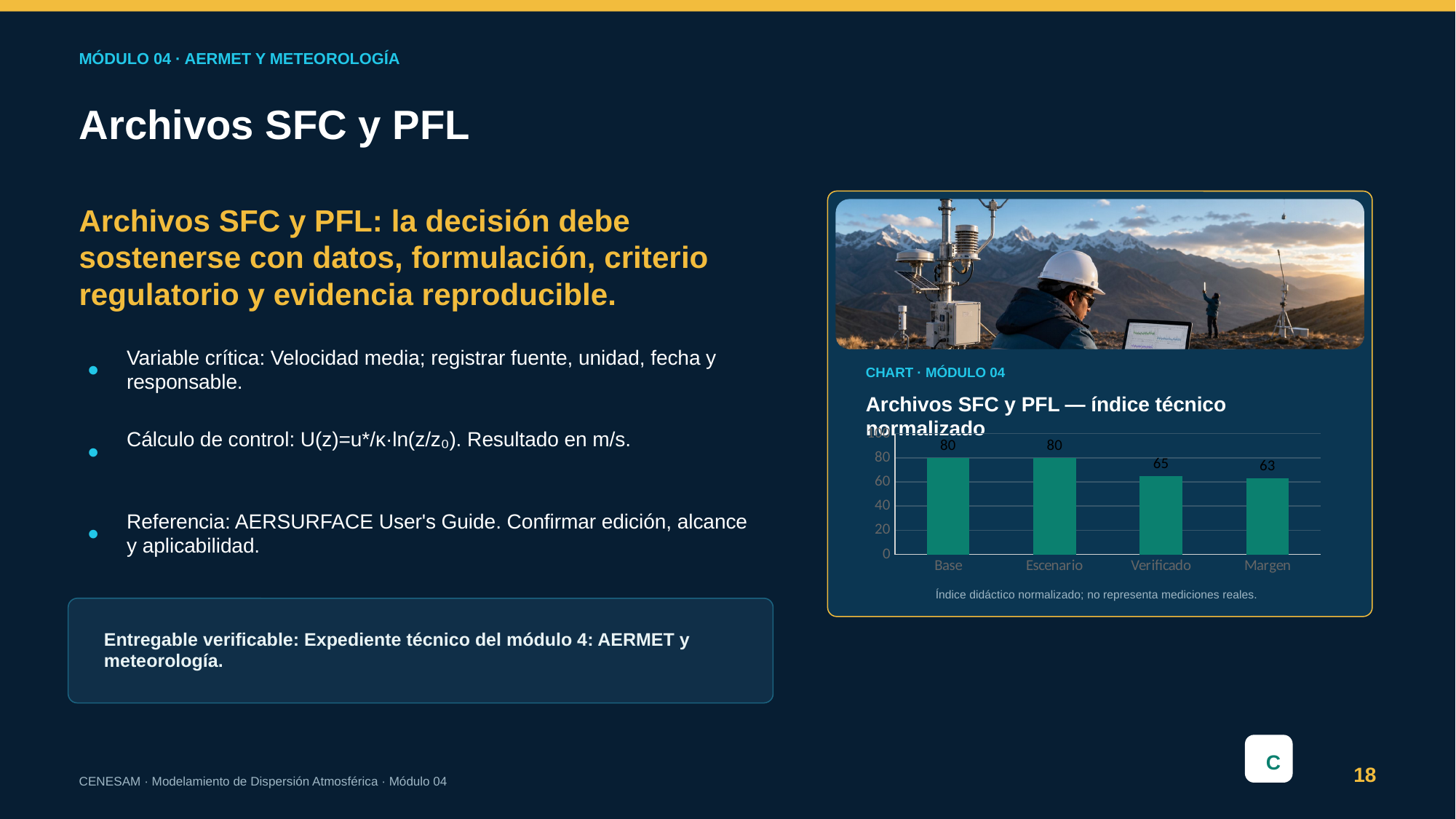
What is the difference between the values for Base and Verificado? 15 What is the value for Escenario? 80 What is the value for Margen? 63 What is the title of the chart? Archivos SFC y PFL — índice técnico normalizado Which is larger, the value for Escenario or the value for Margen? Escenario What is the value for Verificado? 65 What is the value for Base? 80 Is the value for Margen greater or less than 80? less What is the difference between the values for Verificado and Margen? 2 Which category has the lowest value? Margen What kind of chart is shown? bar chart How many categories are shown on the x axis? 4